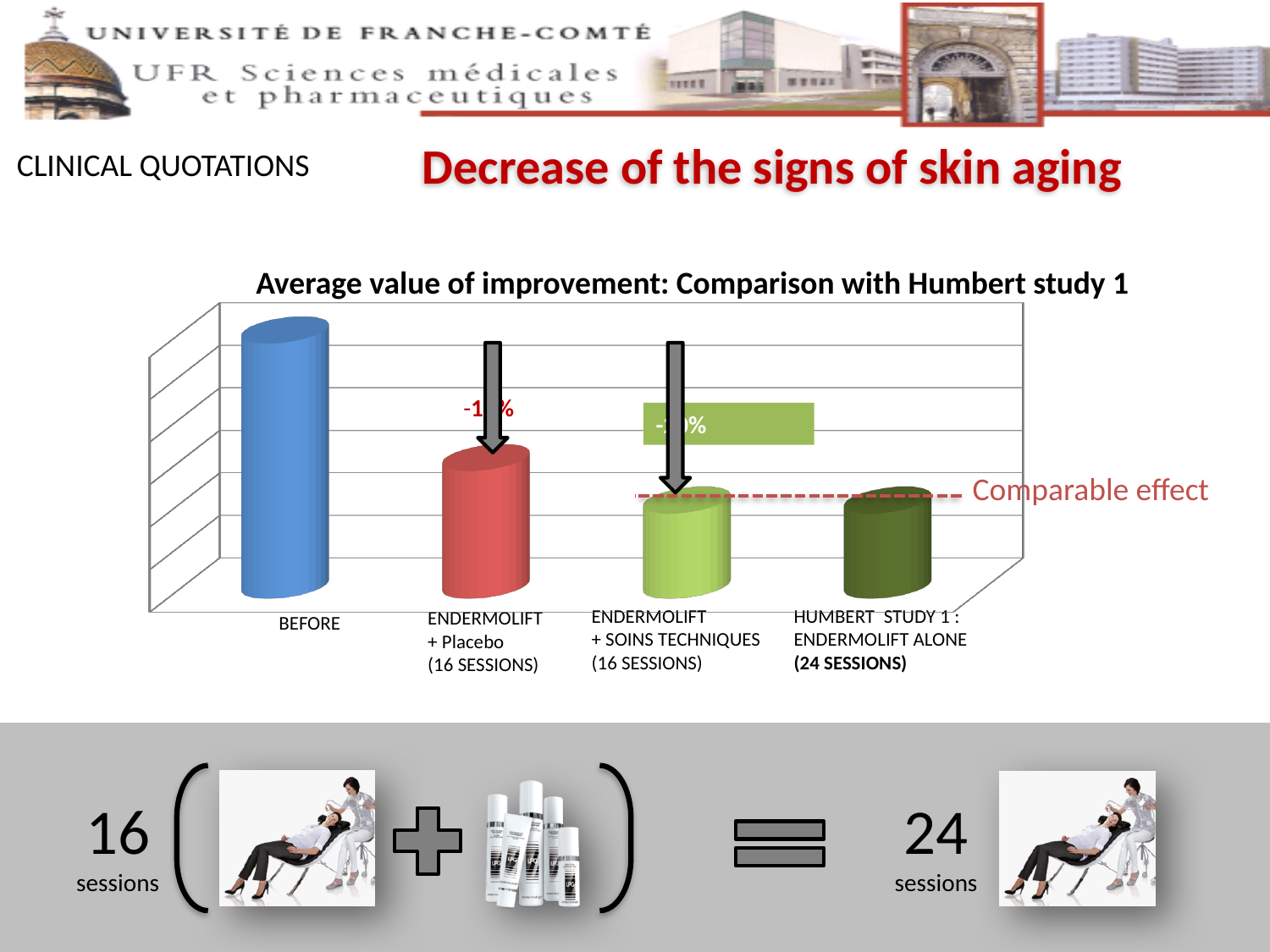
How many categories are plotted in the chart? 4 What kind of chart is shown on the slide? bar chart Do the bar values generally rise or fall from left to right across the chart? fall Which bar is taller: ENDERMOLIFT + Placebo (16 SESSIONS) or ENDERMOLIFT + SOINS TECHNIQUES (16 SESSIONS)? ENDERMOLIFT + Placebo (16 SESSIONS) What is the label of the first (leftmost) category in the chart? BEFORE What is the title of the chart? Average value of improvement: Comparison with Humbert study 1 Which category has the highest bar in the chart? BEFORE Which bar is taller: BEFORE or HUMBERT STUDY 1: ENDERMOLIFT ALONE (24 SESSIONS)? BEFORE What label is written next to the dashed horizontal line in the chart? Comparable effect Which bar is taller: BEFORE or ENDERMOLIFT + Placebo (16 SESSIONS)? BEFORE